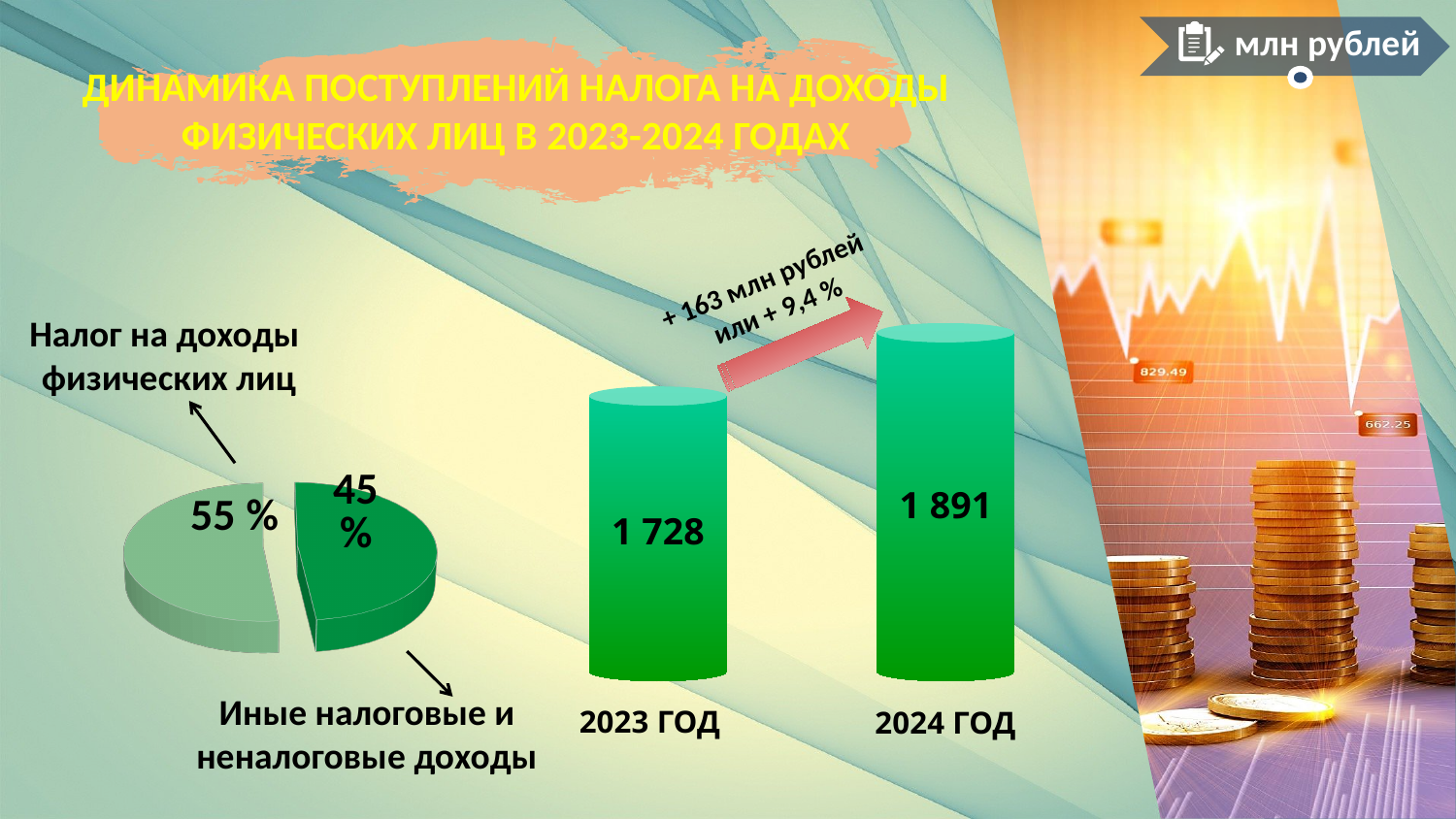
On the bar chart, do the values rise or fall from 2023 to 2024? rise On the bar chart, which year has the higher value? 2024 год On the pie chart, what share is labelled Иные налоговые и неналоговые доходы? 45 % What kind of chart shows the values for 2023 год and 2024 год? bar chart On the bar chart, which year has the lower value? 2023 год On the pie chart, which slice is larger: Налог на доходы физических лиц or Иные налоговые и неналоговые доходы? Налог на доходы физических лиц On the bar chart, how many bars are shown? 2 On the bar chart, what is the value for 2024 год? 1 891 On the bar chart, what is the value for 2023 год? 1 728 On the bar chart, what is the difference between the 2024 and 2023 values? 163 On the pie chart, what share is labelled Налог на доходы физических лиц? 55 % What unit of measurement is indicated in the top-right corner of the slide? млн рублей